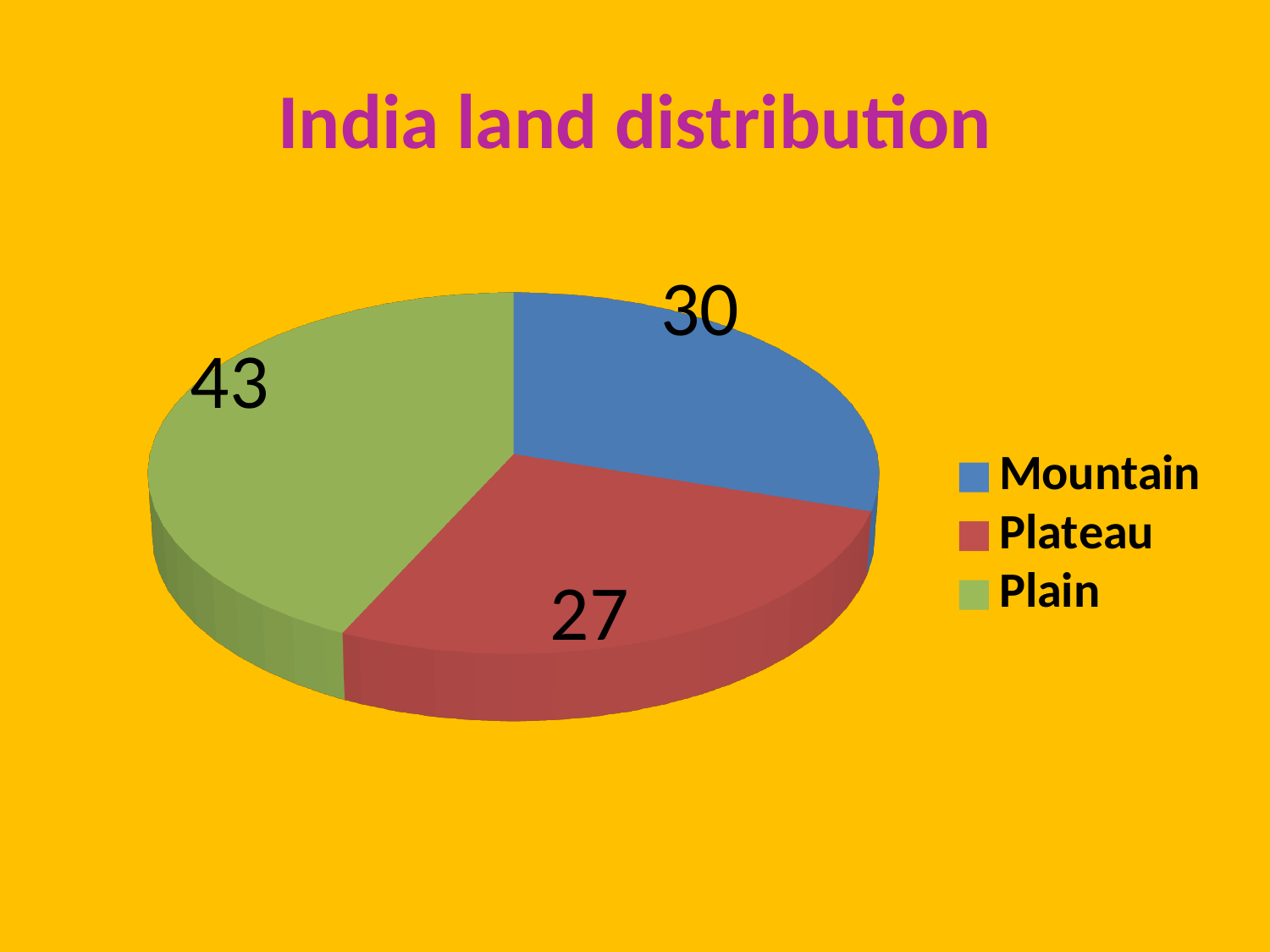
What is the title of the chart? India land distribution What is the difference between the values for Mountain and Plateau? 3 Which is larger, the value for Plain or the value for Plateau? Plain How many categories does the pie chart show? 3 Which colour represents Plateau in the legend? Red What is the value for Plateau? 27 What is the value for Mountain? 30 What is the value for Plain? 43 What is the difference between the values for Plain and Mountain? 13 What kind of chart is shown on the slide? Pie chart Which category has the smallest slice? Plateau Which category has the largest slice? Plain